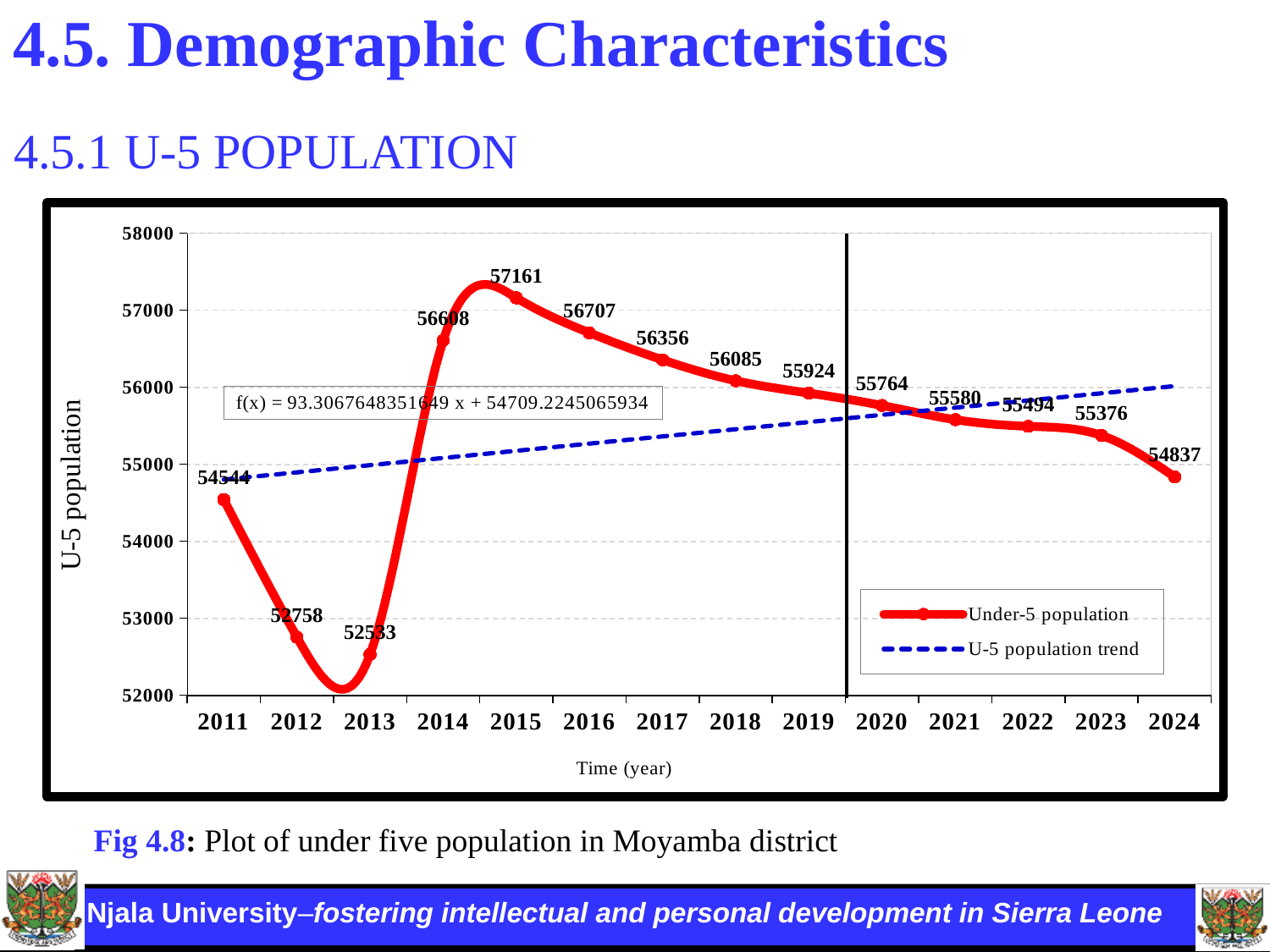
Which is larger, the under-5 population value for 2016 or for 2020? 2016 Do the under-5 population values rise or fall from 2015 to 2024? fall What is the under-5 population value shown for 2024? 54837 What kind of chart is shown? line chart Which year has the lowest under-5 population value? 2013 What is the under-5 population value shown for 2011? 54544 How many years are plotted on the x axis? 14 What is the difference between the under-5 population values for 2015 and 2013? 4628 How many series does the legend list? 2 What is the under-5 population value shown for 2015? 57161 What is the difference between the under-5 population values for 2014 and 2012? 3850 Which year has the highest under-5 population value? 2015